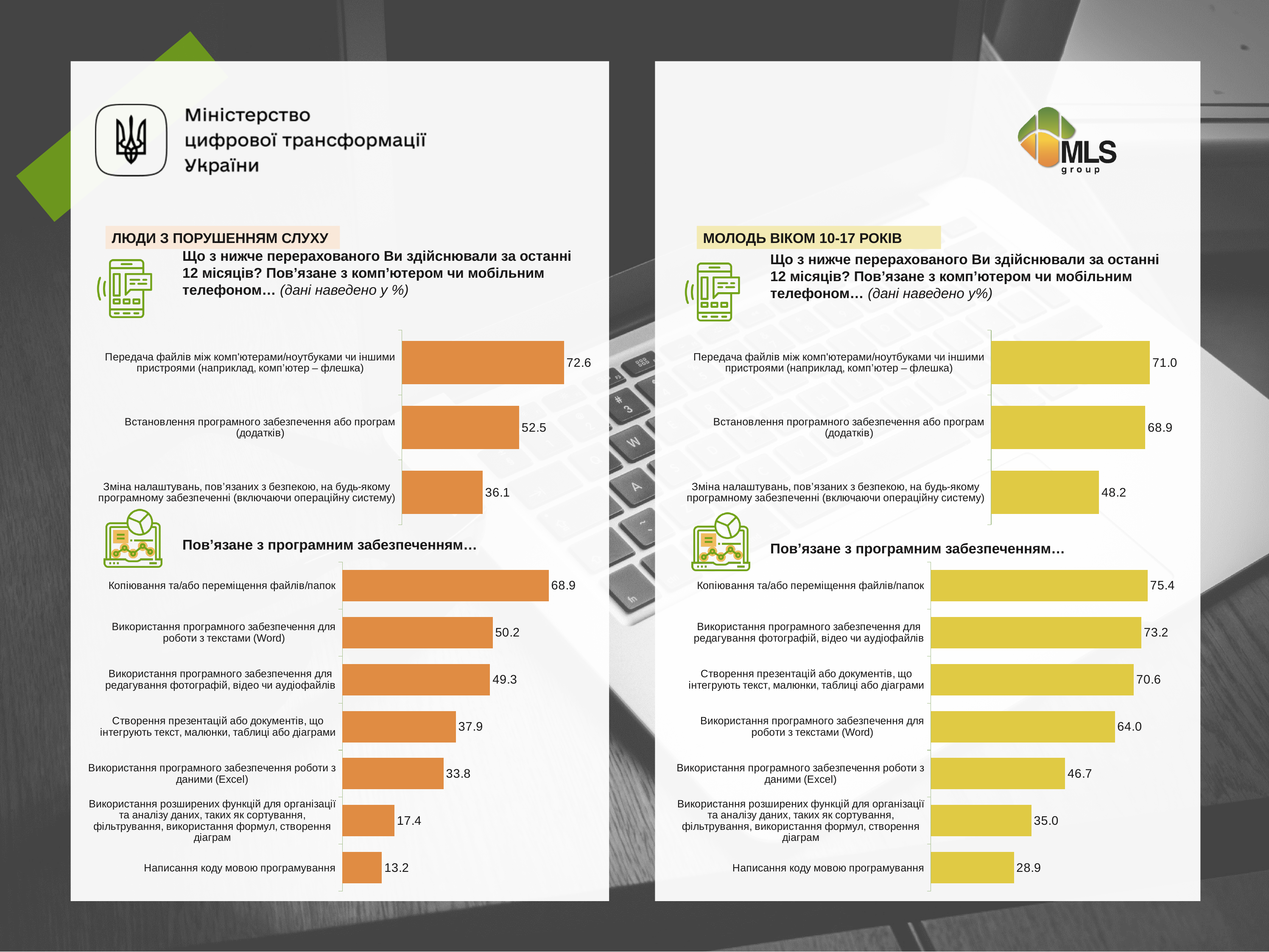
How many categories are shown in the top chart of the left panel? 3 How many categories are shown in the bottom chart of the right panel? 7 In the bottom chart of the right panel (Пов'язане з програмним забезпеченням), which category has the highest value? Копіювання та/або переміщення файлів/папок What colour are the bars in the right panel (МОЛОДЬ ВІКОМ 10-17 РОКІВ)? Yellow In the top chart of the left panel, what is the difference between 'Передача файлів...' (72.6) and 'Зміна налаштувань, пов'язаних з безпекою...' (36.1)? 36.5 In the bottom chart of the right panel, what is the value for 'Використання програмного забезпечення для роботи з текстами (Word)'? 64.0 In the bottom chart of the left panel (Пов'язане з програмним забезпеченням), what is the value for 'Написання коду мовою програмування'? 13.2 In the bottom chart of the left panel, which category has the lowest value? Написання коду мовою програмування In the top chart of the left panel (ЛЮДИ З ПОРУШЕННЯМ СЛУХУ), what is the value for 'Передача файлів між комп'ютерами/ноутбуками чи іншими пристроями'? 72.6 What type of chart is used in the left panel? Bar chart Comparing the bottom charts of both panels, which group has the higher value for 'Використання програмного забезпечення роботи з даними (Excel)': people with hearing impairment or youth aged 10-17? Youth aged 10-17 (46.7 vs 33.8) In the top chart of the right panel (МОЛОДЬ ВІКОМ 10-17 РОКІВ), what is the value for 'Встановлення програмного забезпечення або програм (додатків)'? 68.9